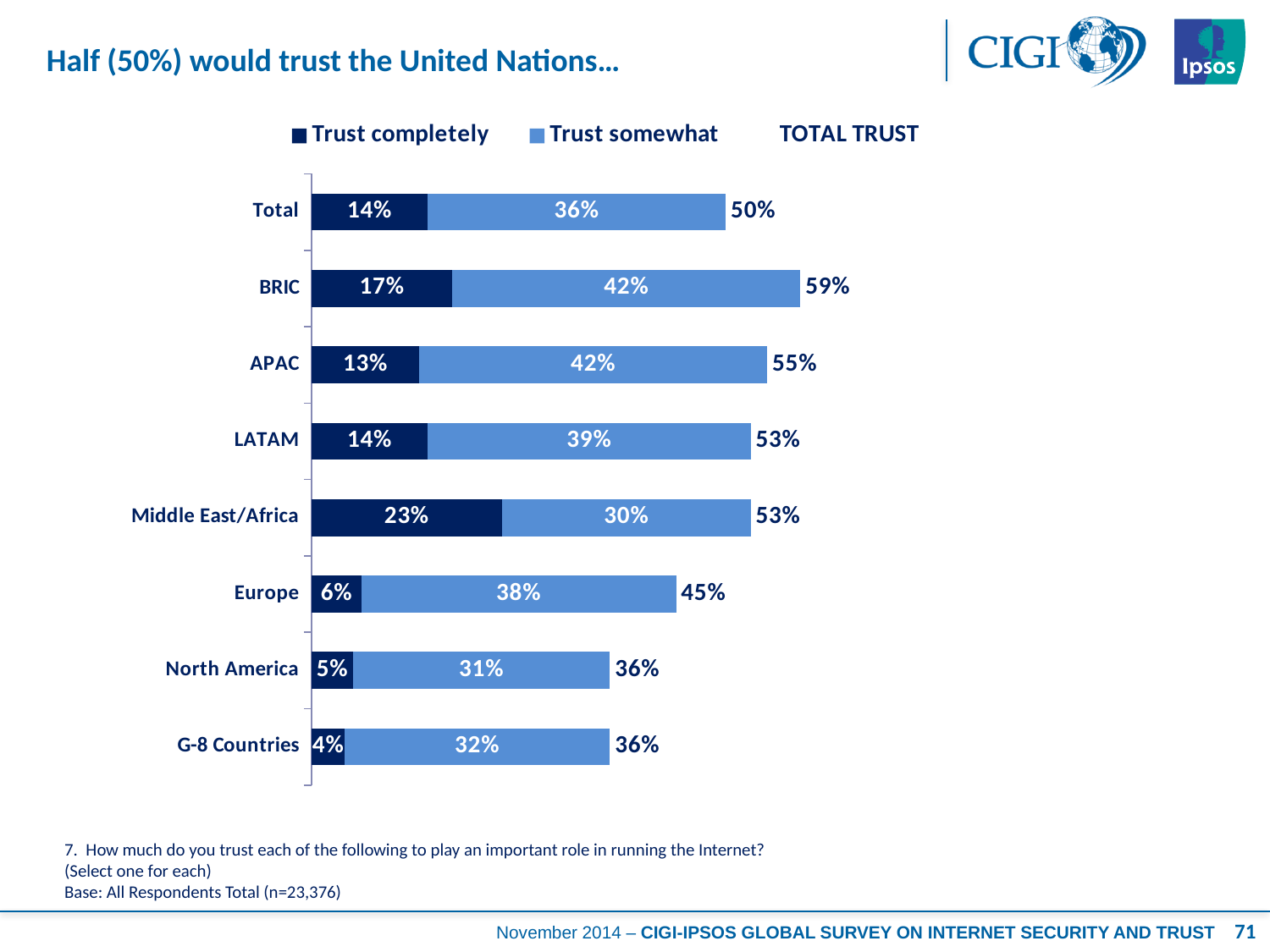
Which category has the highest TOTAL TRUST value? BRIC What is the total of the stacked bar for Total? 50% What is the 'Trust completely' value for Middle East/Africa? 23% How many series does the legend list? 3 What is the 'Trust somewhat' value for BRIC? 42% What kind of chart is shown on the slide? Stacked bar chart What is the TOTAL TRUST value for Europe? 45% Which is larger, the 'Trust completely' value for BRIC or for LATAM? BRIC What is the difference between the 'Trust somewhat' values for APAC and North America? 11% Which category has the lowest 'Trust completely' value? G-8 Countries Which category has the highest 'Trust completely' value? Middle East/Africa How many categories are shown on the chart? 8